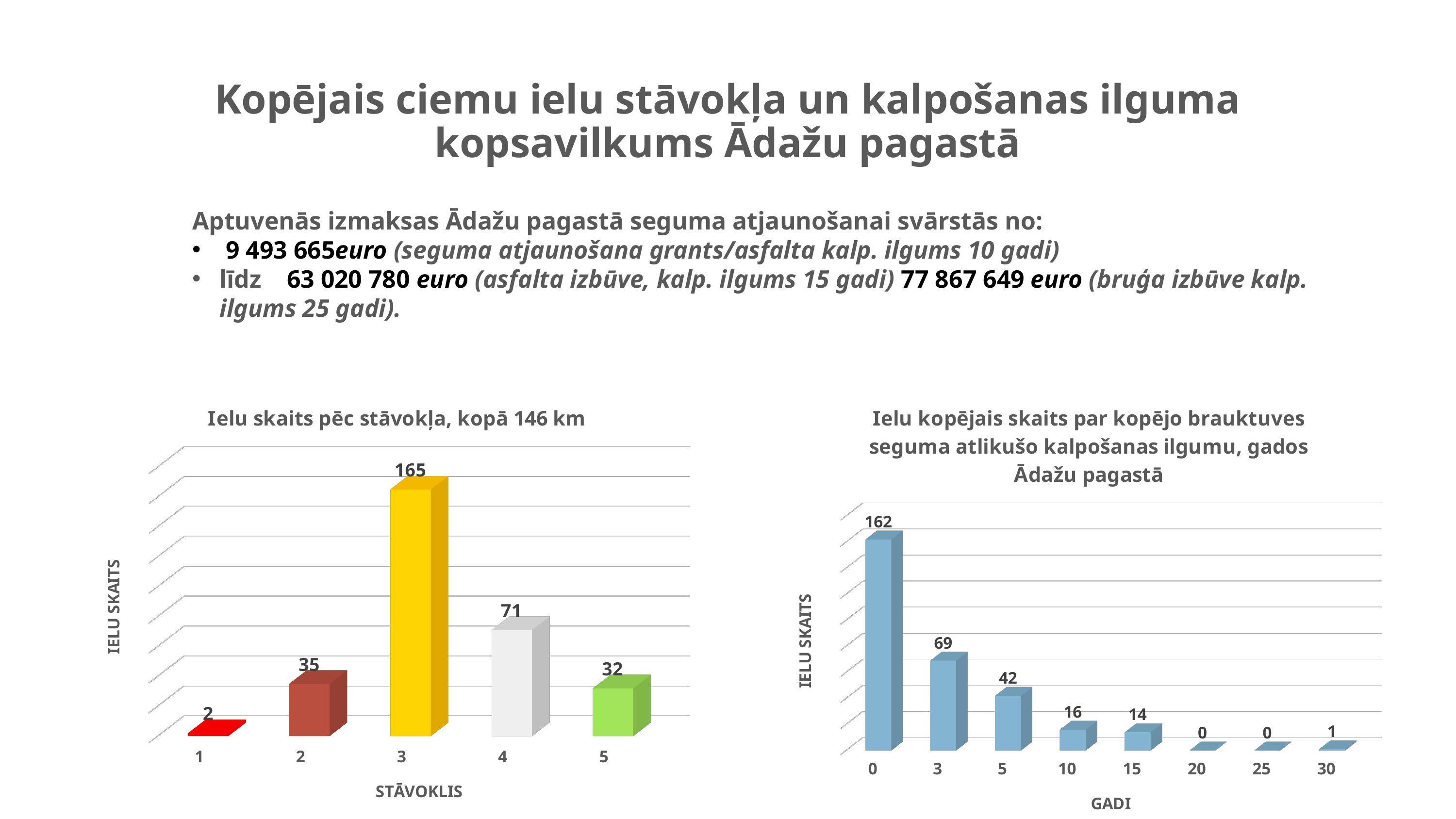
In the right chart 'Ielu kopējais skaits par kopējo brauktuves seguma atlikušo kalpošanas ilgumu', what is the value for 10 gadi? 16 What kind of chart is the right chart 'Ielu kopējais skaits par kopējo brauktuves seguma atlikušo kalpošanas ilgumu'? bar chart In the right chart 'Ielu kopējais skaits par kopējo brauktuves seguma atlikušo kalpošanas ilgumu', what is the value for 0 gadi? 162 In the left chart 'Ielu skaits pēc stāvokļa, kopā 146 km', which stāvoklis category has the lowest value? 1 In the left chart 'Ielu skaits pēc stāvokļa, kopā 146 km', what is the value for stāvoklis 5? 32 In the left chart 'Ielu skaits pēc stāvokļa, kopā 146 km', what is the label of the y axis? IELU SKAITS In the right chart 'Ielu kopējais skaits par kopējo brauktuves seguma atlikušo kalpošanas ilgumu', which gadi category has the highest value? 0 In the left chart 'Ielu skaits pēc stāvokļa, kopā 146 km', how many stāvoklis categories are shown on the x axis? 5 In the left chart 'Ielu skaits pēc stāvokļa, kopā 146 km', what is the difference between the values for stāvoklis 4 and stāvoklis 2? 36 In the left chart 'Ielu skaits pēc stāvokļa, kopā 146 km', what is the value for stāvoklis 3? 165 In the right chart 'Ielu kopējais skaits par kopējo brauktuves seguma atlikušo kalpošanas ilgumu', how many gadi categories are shown on the x axis? 8 In the right chart 'Ielu kopējais skaits par kopējo brauktuves seguma atlikušo kalpošanas ilgumu', which is larger, the value for 3 gadi or the value for 5 gadi? 3 gadi